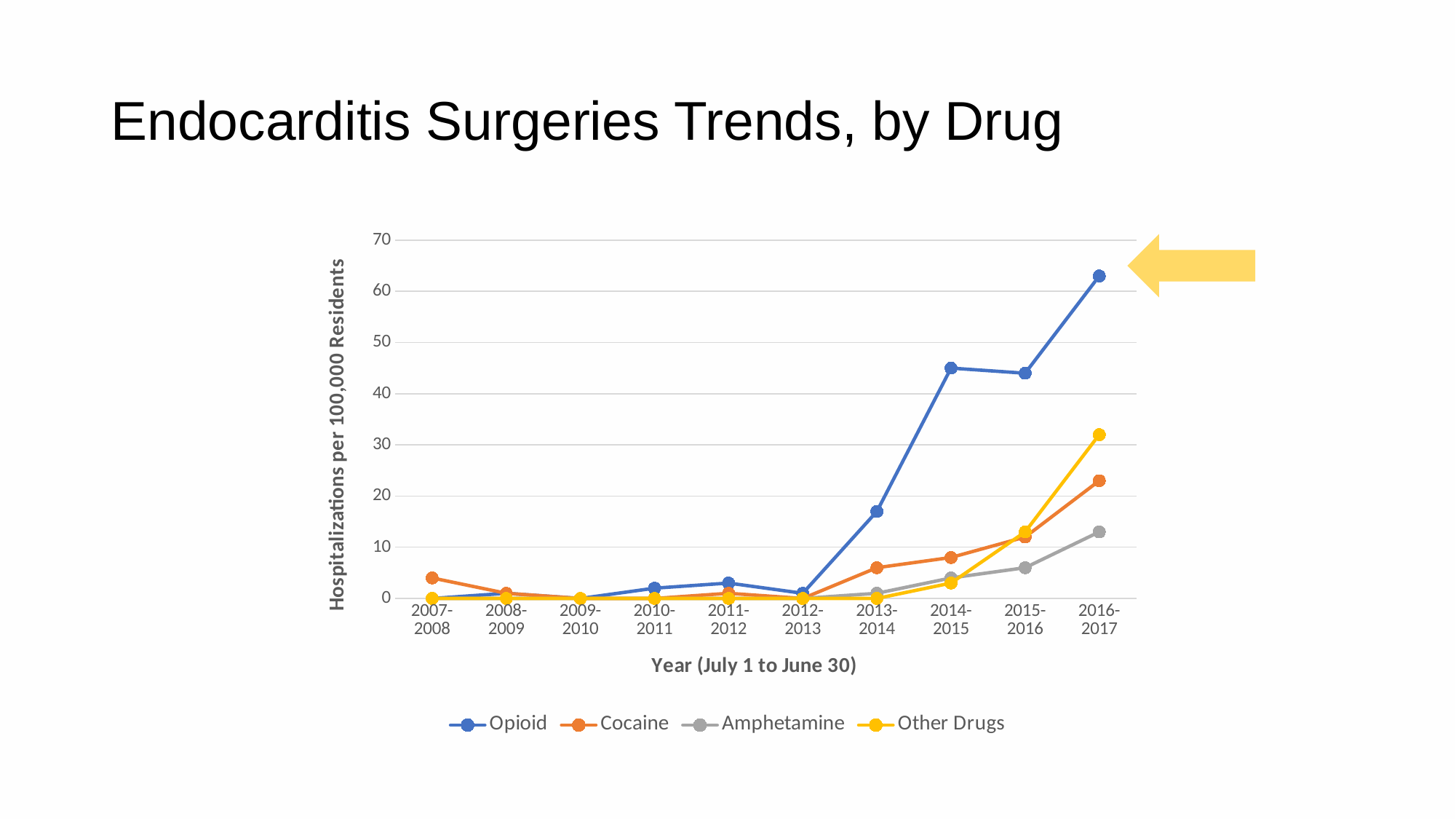
In 2016-2017, which is larger: the Other Drugs value or the Cocaine value? Other Drugs How many series does the legend list? 4 Is the Opioid value for 2013-2014 greater or less than 20? less Is the Cocaine value for 2016-2017 greater or less than 20? greater How many year categories are shown on the x axis? 10 What kind of chart is shown on the slide? line chart Which series has the highest value in 2016-2017? Opioid What is the label of the y axis? Hospitalizations per 100,000 Residents Is the Opioid value for 2016-2017 greater or less than 60? greater Does the Opioid series rise or fall overall from 2012-2013 to 2016-2017? rise Which series has the lowest value in 2016-2017? Amphetamine